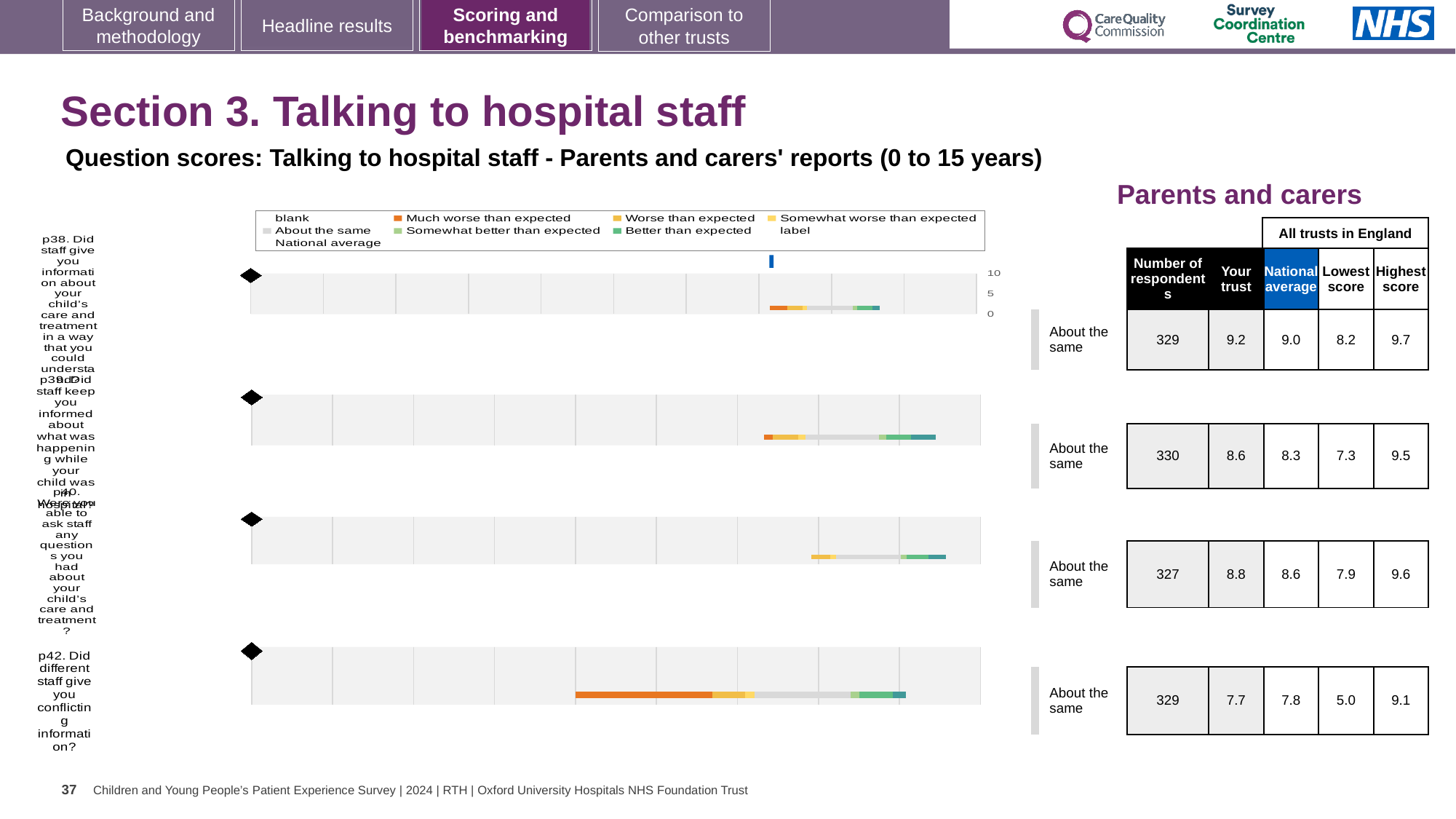
In the table, what is the national average for p39 (Did staff keep you informed about what was happening while your child was in hospital)? 8.3 In the table, what is the lowest score across all trusts in England for p42 (Did different staff give you conflicting information)? 5.0 What kind of chart is used to show the benchmarking results for each question on this slide? bar chart In the chart legend, which colour represents 'Much worse than expected'? orange In the table next to the charts, what is the 'Your trust' score for p38 (Did staff give you information about your child's care and treatment in a way that you could understand)? 9.2 Which question has the highest 'Your trust' score in the table? p38 In the table, how many respondents are listed for p40 (Were you able to ask staff any questions you had about your child's care and treatment)? 327 For p42, which is larger: the 'Your trust' score or the national average? National average How many question charts (p38, p39, p40, p42) are shown on the slide? 4 What is the difference between the 'Your trust' score and the national average for p39? 0.3 What benchmark category label is shown beside each of the four charts? About the same Which question has the lowest 'Your trust' score in the table? p42